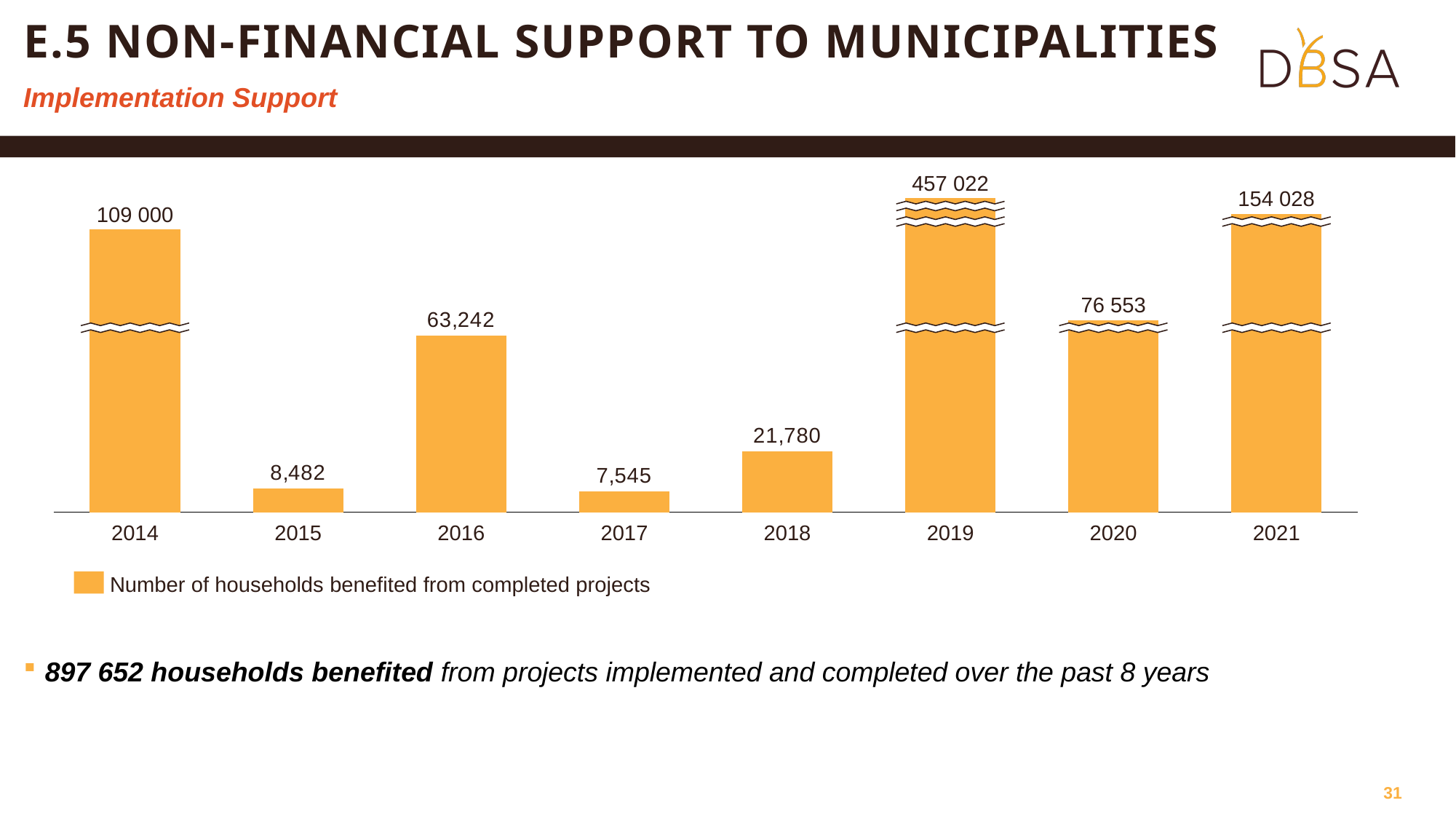
What kind of chart is shown on the slide? Bar chart What series does the legend of the chart list? Number of households benefited from completed projects What value is shown for 2021? 154 028 Which year has the lowest number of households benefited from completed projects? 2017 How many years are shown on the x axis of the chart? 8 What is the value shown for 2019? 457 022 Which year has the highest number of households benefited from completed projects? 2019 How many households benefited from completed projects in 2014? 109 000 Which year has the larger value, 2014 or 2016? 2014 What is the difference between the values for 2016 and 2015? 54,760 What is the difference between the values for 2021 and 2020? 77 475 What is the number of households benefited from completed projects in 2017? 7,545